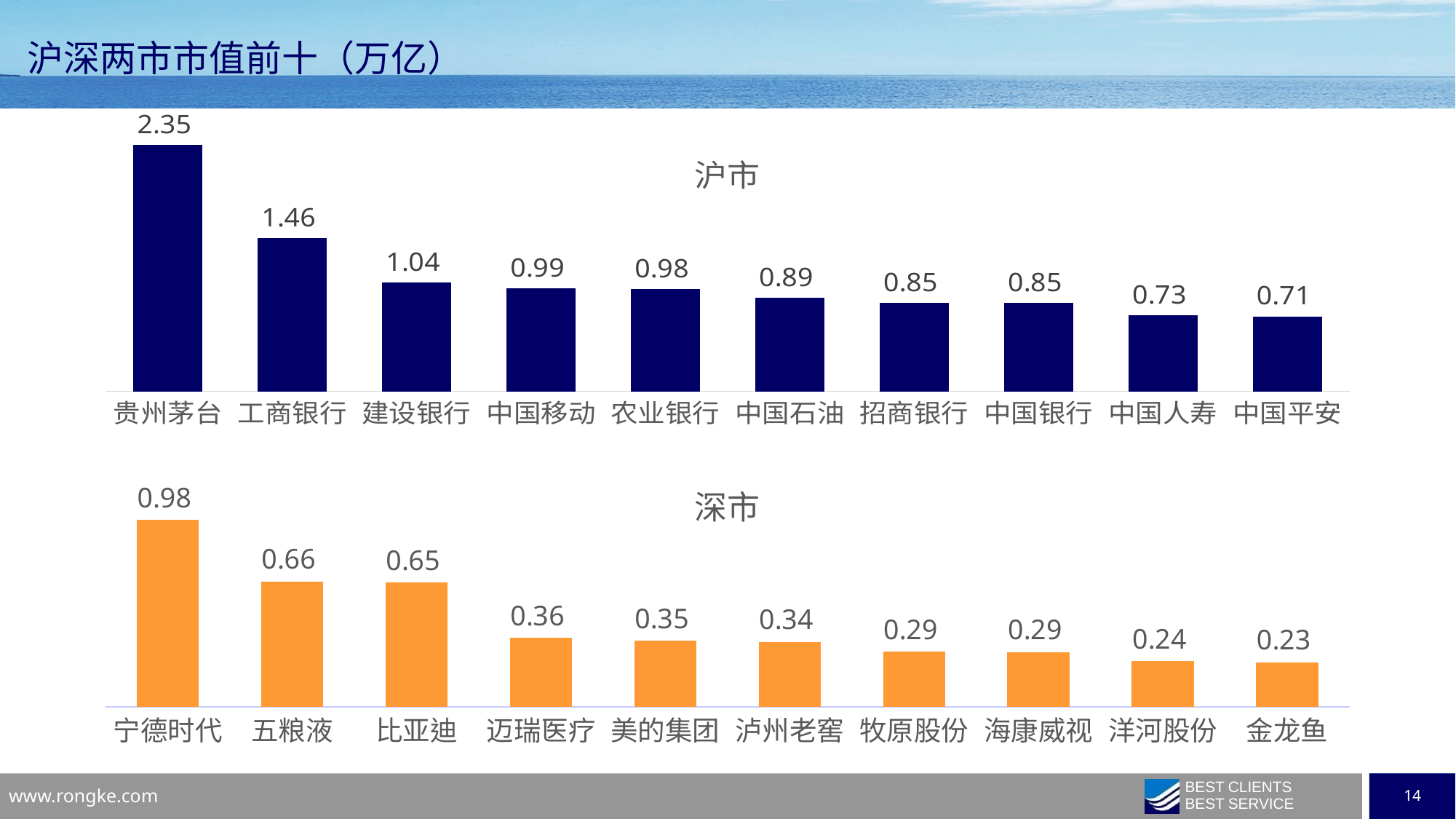
In the 沪市 chart, what is the difference between the values for 贵州茅台 and 工商银行? 0.89 In the 沪市 chart, which is larger, the value for 建设银行 or the value for 中国石油? 建设银行 In the 深市 chart, which category has the lowest value? 金龙鱼 In the 深市 chart, what is the difference between the values for 宁德时代 and 五粮液? 0.32 In the 沪市 chart, do the values rise or fall from left to right? fall What is the title of the slide? 沪深两市市值前十（万亿） In the 沪市 chart, what is the value for 贵州茅台? 2.35 How many categories are shown in the 深市 chart? 10 In the 深市 chart, what is the value for 比亚迪? 0.65 In the 沪市 chart, which category has the highest value? 贵州茅台 What kind of chart is the 沪市 chart? bar chart In the 深市 chart, which is larger, the value for 迈瑞医疗 or the value for 洋河股份? 迈瑞医疗